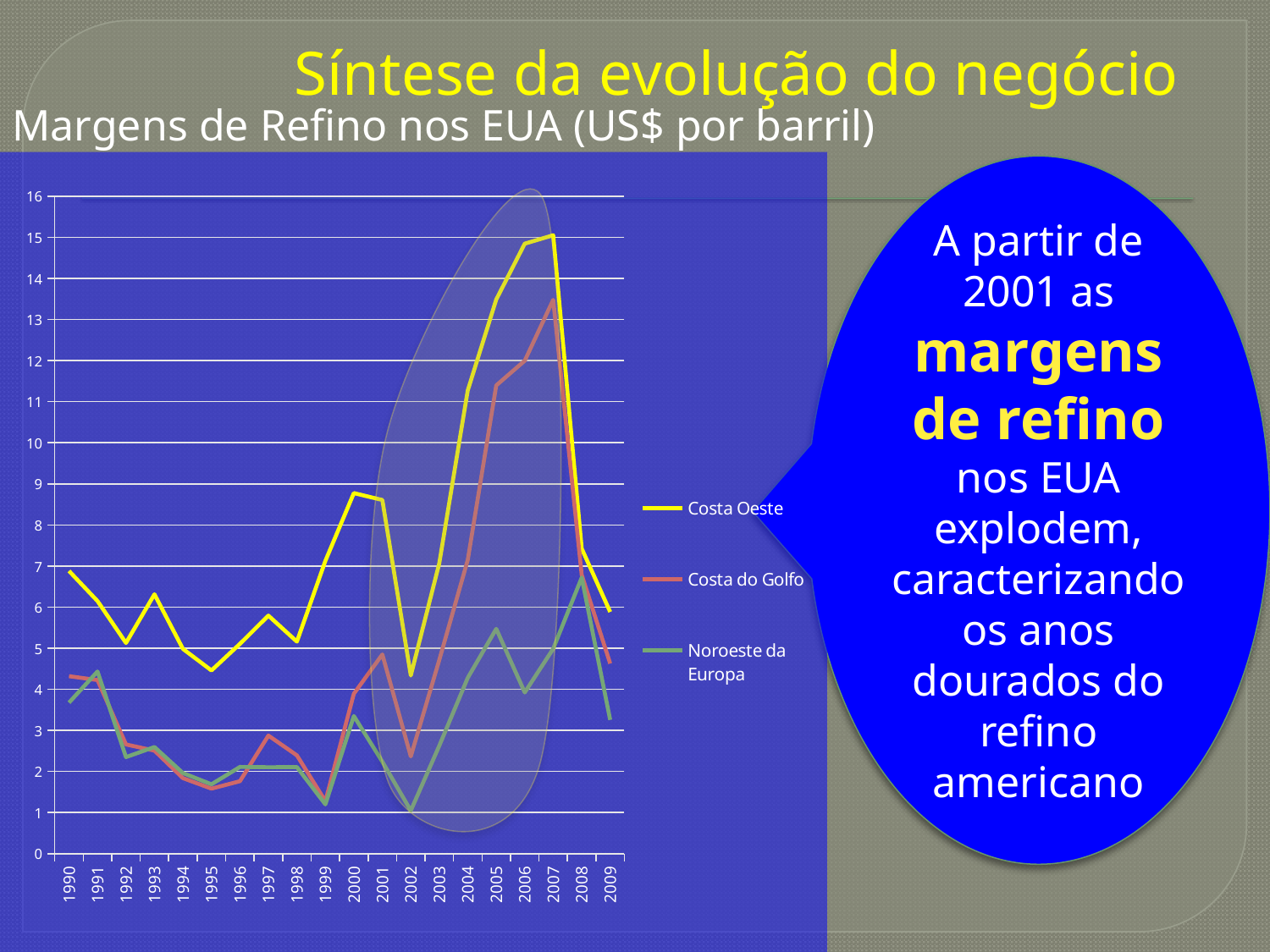
How many years are plotted along the x axis of the chart? 20 Is the Costa do Golfo value for 2007 greater or less than 12? greater What kind of chart is shown on the slide? line chart What colour is the Costa Oeste line in the chart? yellow In which year does the Costa Oeste series reach its highest value? 2007 Is the Noroeste da Europa value for 2002 greater or less than 2? less How many series does the chart legend list? 3 In 2007, which series has the larger value, Costa Oeste or Costa do Golfo? Costa Oeste In 2009, which series has the larger value, Costa do Golfo or Noroeste da Europa? Costa do Golfo Does the Costa Oeste series rise or fall from 2007 to 2009? fall Is the Costa Oeste value for 2007 greater or less than 14? greater